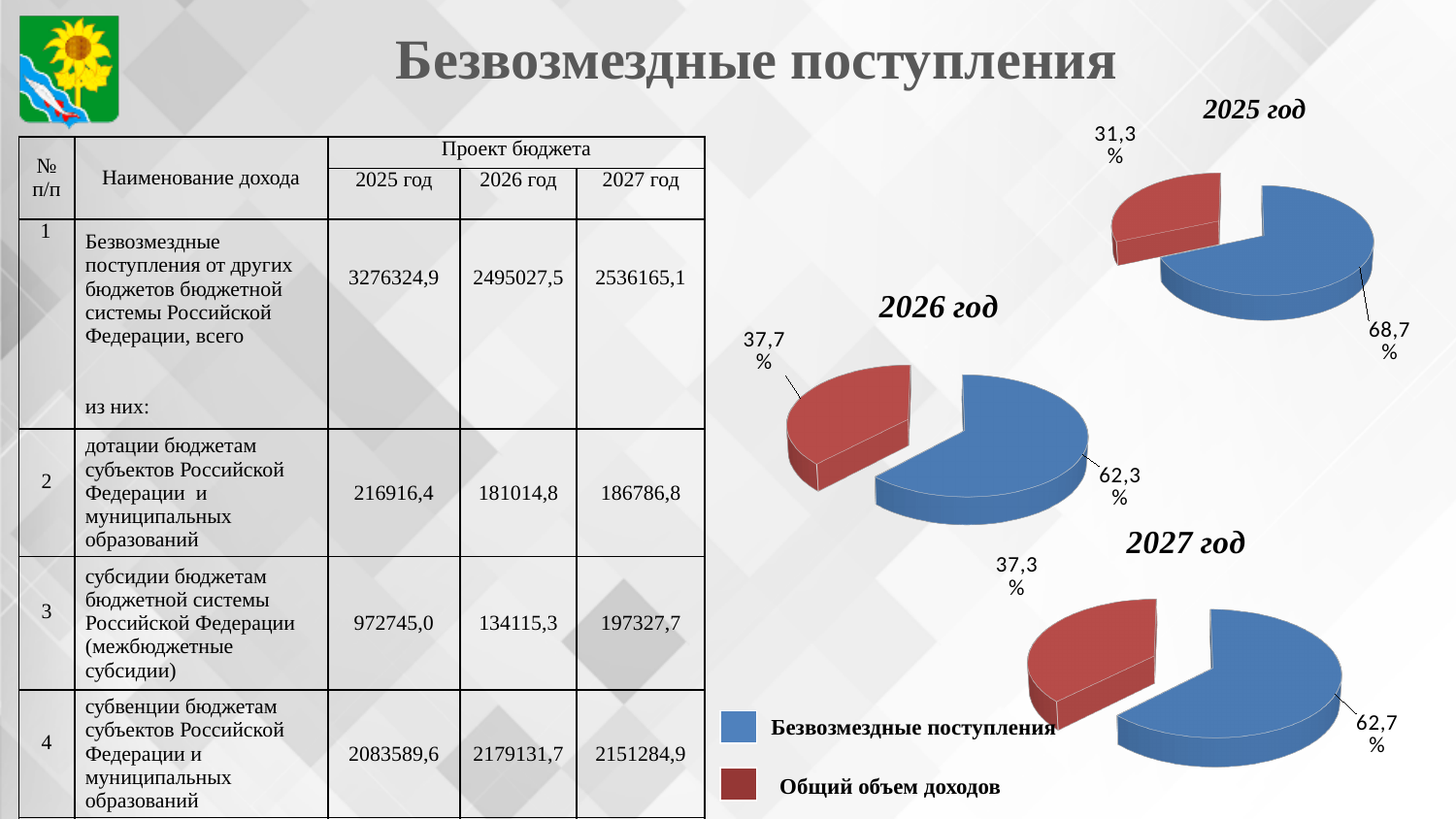
Which colour represents Общий объем доходов in the pie charts? Red In the 2025 год pie chart, what share is shown for Безвозмездные поступления? 68,7% In the 2026 год pie chart, what is the difference between the Безвозмездные поступления share and the Общий объем доходов share? 24,6% What kind of charts are shown on the slide? Pie charts How many pie charts are on the slide? 3 In the 2026 год pie chart, what share is shown for Общий объем доходов? 37,7% In the 2025 год pie chart, which slice is larger, Безвозмездные поступления or Общий объем доходов? Безвозмездные поступления In the 2025 год pie chart, what share is shown for Общий объем доходов? 31,3% How many entries does the legend list? 2 In the 2027 год pie chart, what share is shown for Безвозмездные поступления? 62,7% In the 2026 год pie chart, what share is shown for Безвозмездные поступления? 62,3% In the 2027 год pie chart, what share is shown for Общий объем доходов? 37,3%